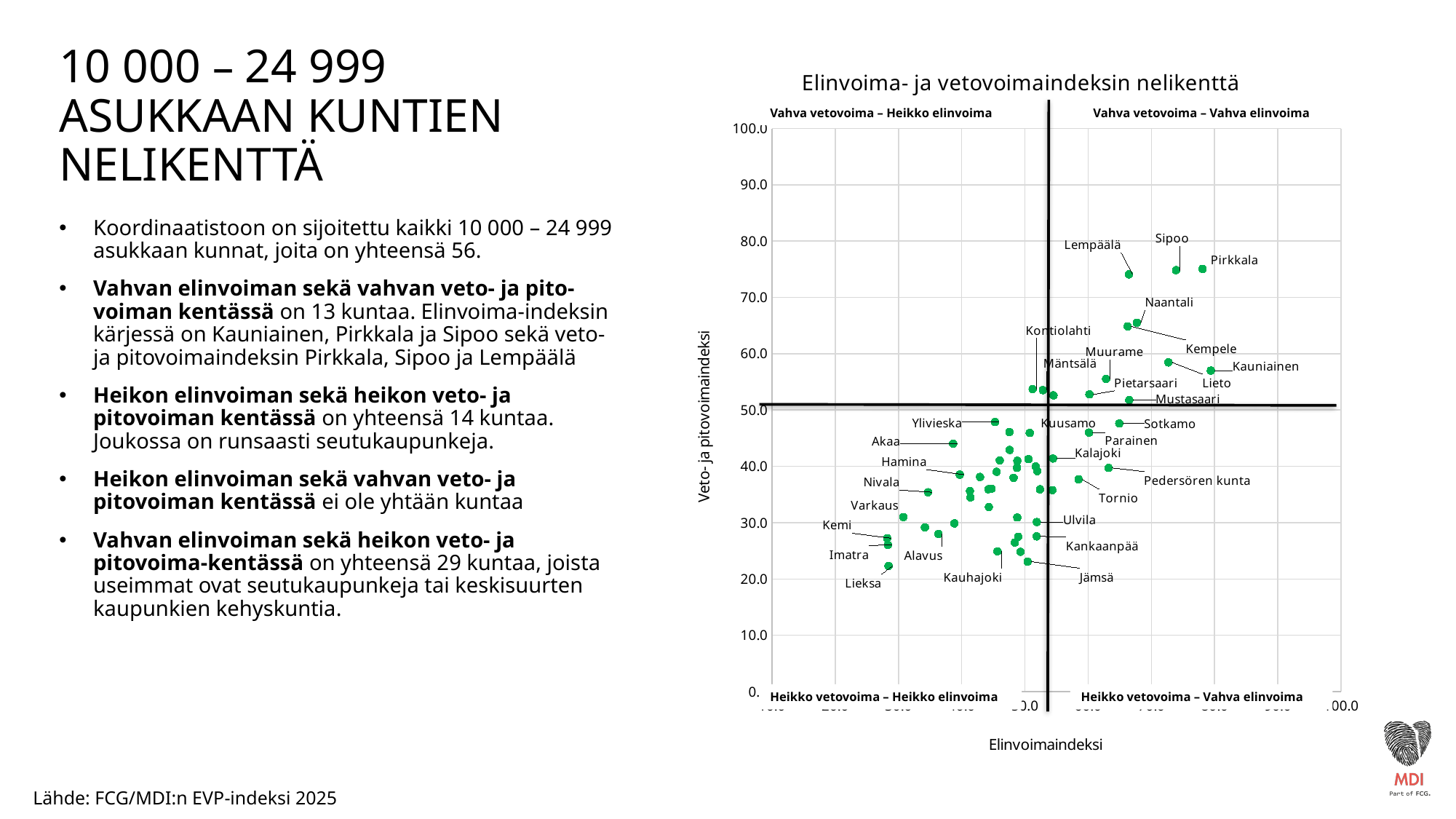
Is the Veto- ja pitovoimaindeksi value for Lieksa greater or less than 30? less Is the Veto- ja pitovoimaindeksi value for Kemi greater or less than 30? less Is the Veto- ja pitovoimaindeksi value for Kauniainen greater or less than 50? greater Which has the higher Veto- ja pitovoimaindeksi value, Lempäälä or Kauhajoki? Lempäälä What is the label of the vertical axis of the chart? Veto- ja pitovoimaindeksi What is the title of the chart? Elinvoima- ja vetovoimaindeksin nelikenttä What kind of chart is shown on the slide? Scatter chart Which has the higher Elinvoimaindeksi value, Kauniainen or Kemi? Kauniainen Which has the higher Veto- ja pitovoimaindeksi value, Pirkkala or Lieksa? Pirkkala